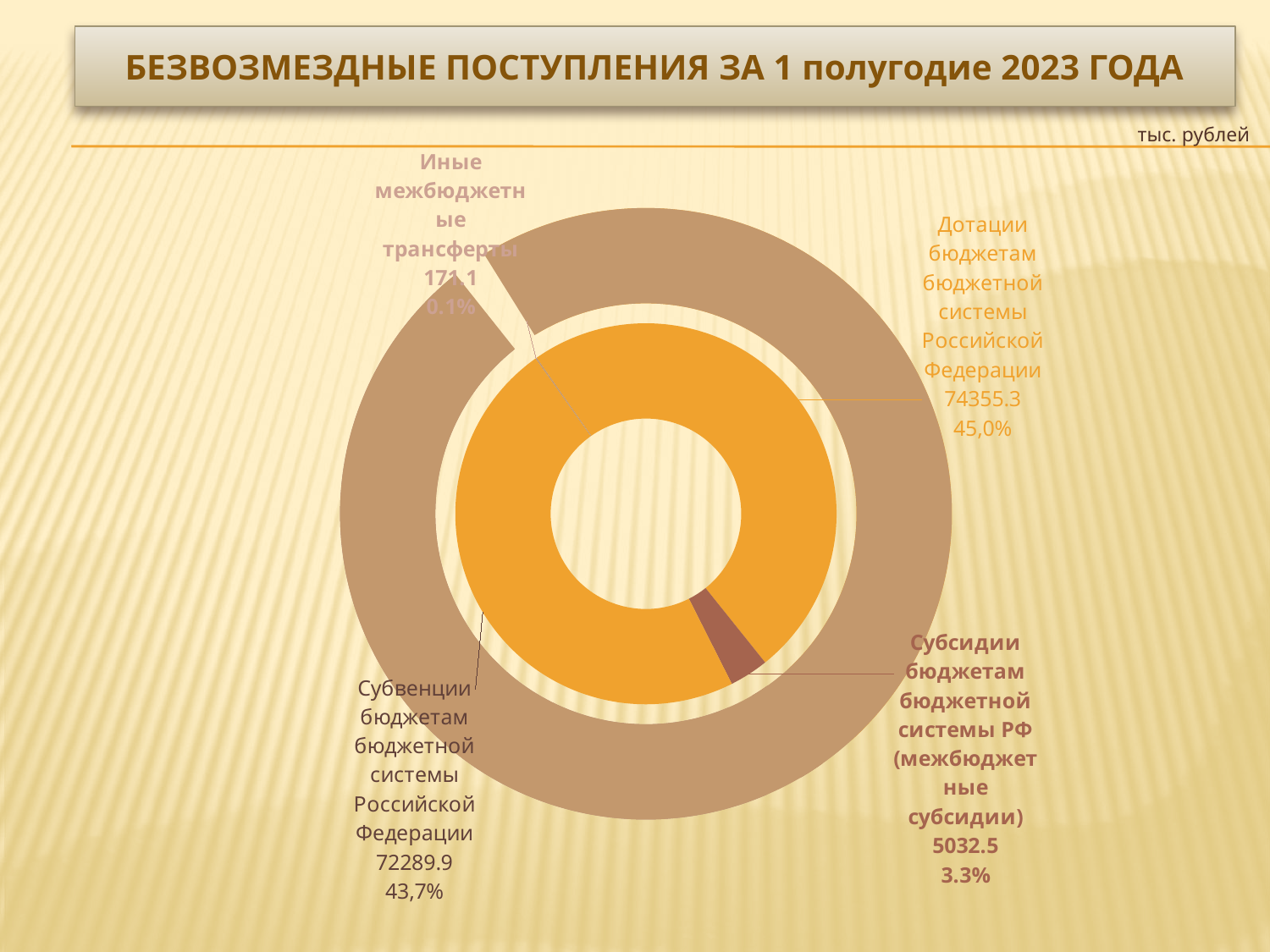
What is the value for Иные межбюджетные трансферты? 171.1 What is the value for Субсидии бюджетам бюджетной системы РФ (межбюджетные субсидии)? 5032.5 What is the value for Субвенции бюджетам бюджетной системы Российской Федерации? 72289.9 What is the value for Дотации бюджетам бюджетной системы Российской Федерации? 74355.3 What share of the chart do Дотации бюджетам бюджетной системы Российской Федерации account for? 45,0% What share of the chart do Субвенции бюджетам бюджетной системы Российской Федерации account for? 43,7% What share of the chart do Субсидии бюджетам бюджетной системы РФ (межбюджетные субсидии) account for? 3.3% Which category has the lowest value? Иные межбюджетные трансферты How many categories are shown in the chart? 4 What is the difference between the values for Дотации and Субвенции? 2065.4 What kind of chart is shown on the slide? Doughnut (pie) chart Which category has the highest value? Дотации бюджетам бюджетной системы Российской Федерации